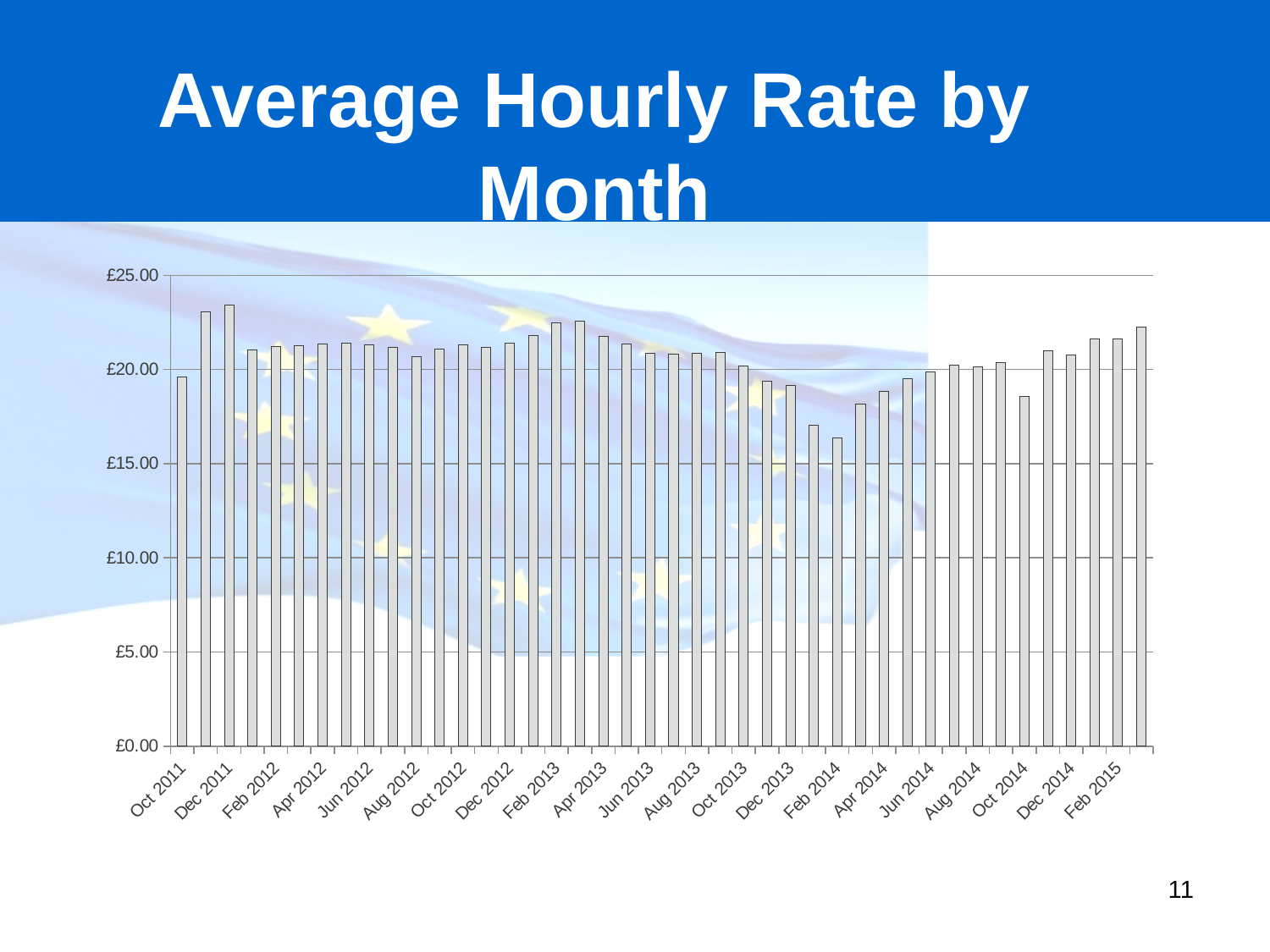
Which is larger, the value for Oct 2014 or the value for Dec 2014? Dec 2014 Is the value for Oct 2014 greater or less than £20.00? less Is the value for Feb 2014 greater or less than £20.00? less Which is larger, the value for Oct 2011 or the value for Dec 2011? Dec 2011 What is the title of the chart? Average Hourly Rate by Month Which labelled month has the lowest average hourly rate? Feb 2014 Do the values generally rise or fall from Feb 2014 to Feb 2015? rise Is the value for Feb 2015 greater or less than £20.00? greater What is the highest value shown on the vertical axis? £25.00 What kind of chart is shown on the slide? Bar chart